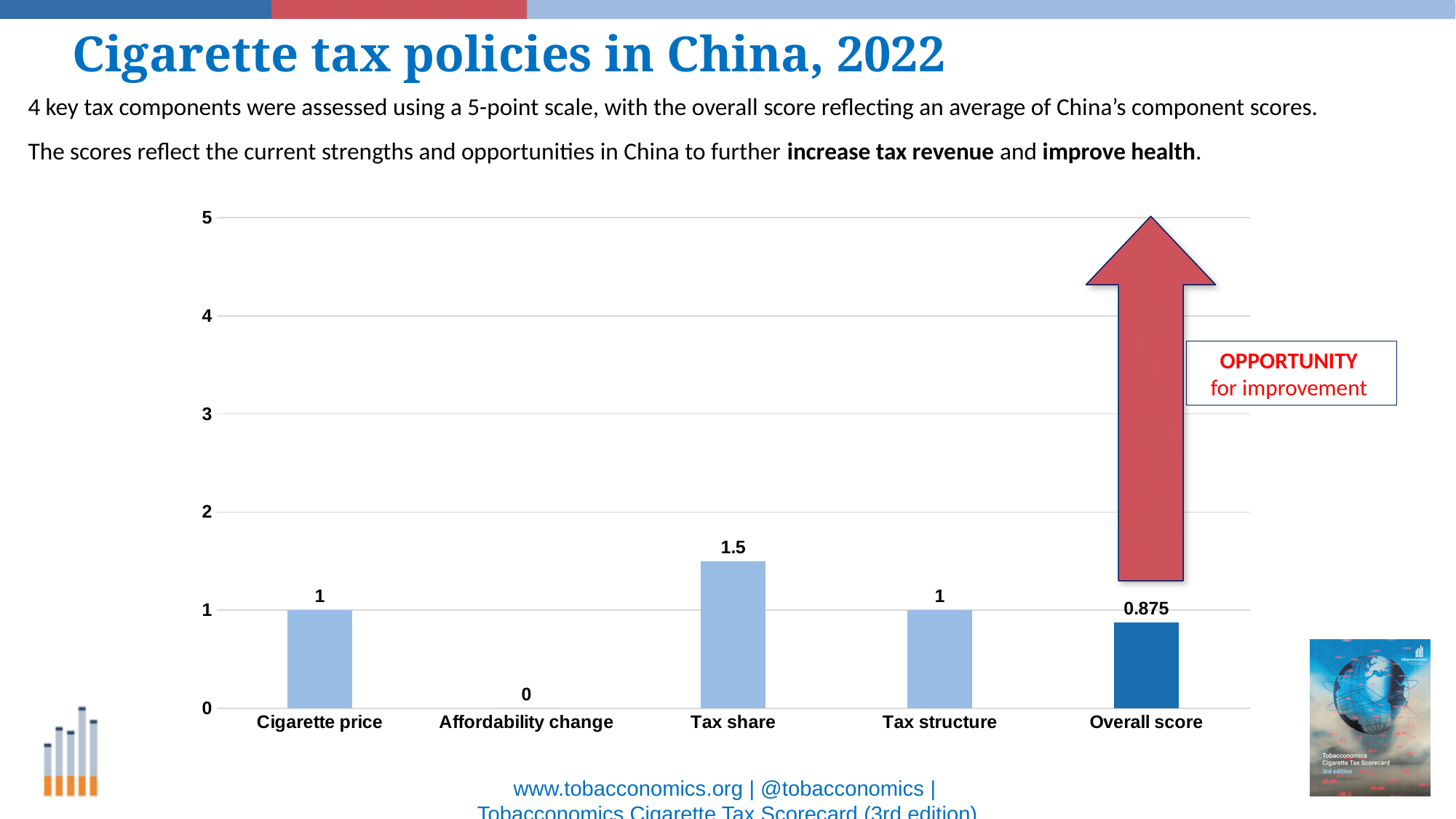
What is the difference between the values for Tax share and Tax structure? 0.5 Which is larger, the value for Cigarette price or the value for Overall score? Cigarette price Is the value for Tax share greater or less than 2? less What kind of chart is shown on the slide? bar chart Which category has the highest value? Tax share Which category has the lowest value? Affordability change What is the value for Tax share? 1.5 How many categories are shown on the x axis? 5 What is the value for Affordability change? 0 What is the value for Overall score? 0.875 What is the value for Cigarette price? 1 What is the highest value shown on the y axis? 5